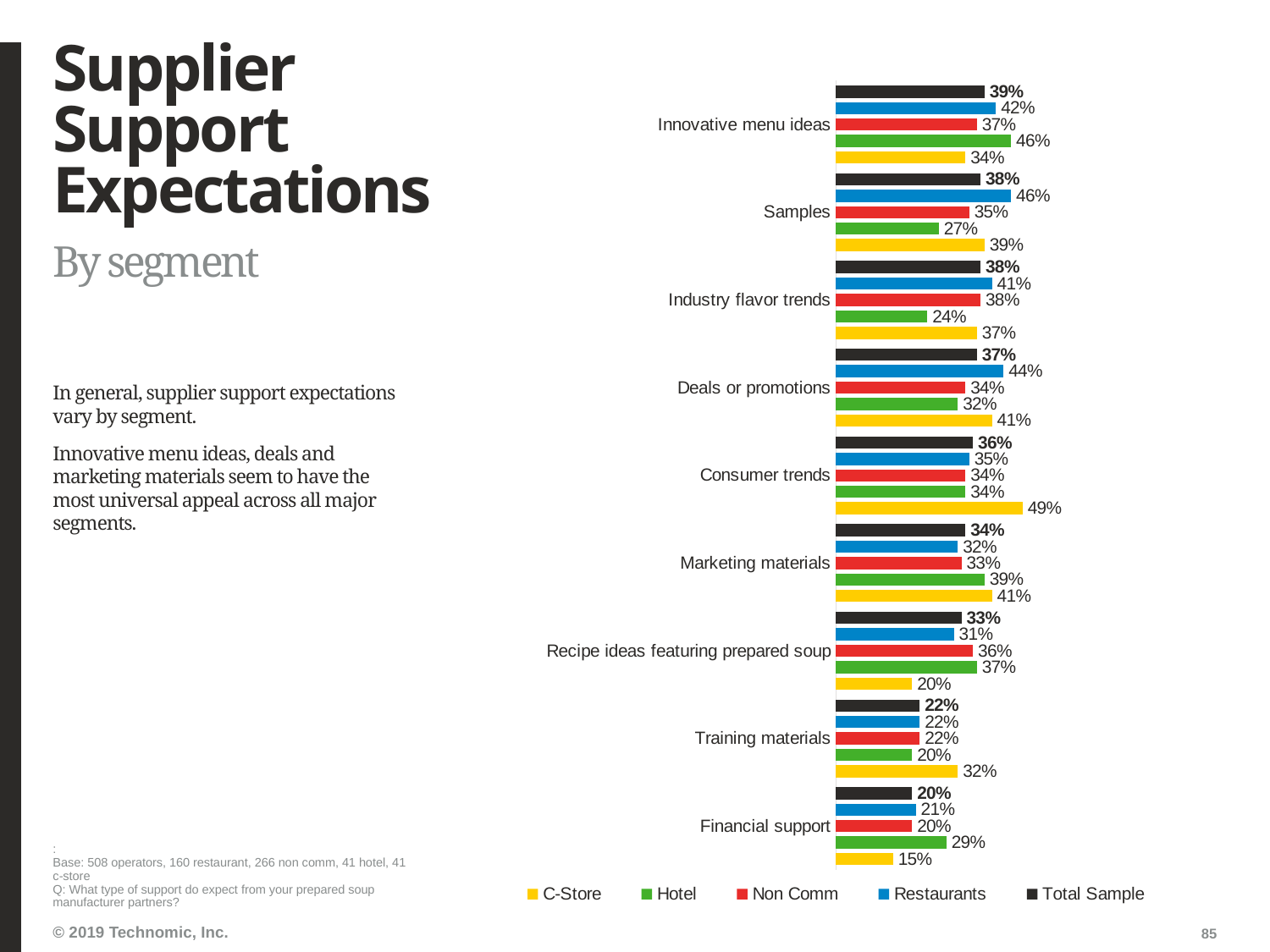
For Deals or promotions, which is larger: the Restaurants value or the Non Comm value? Restaurants What is the difference between the Hotel and C-Store values for Innovative menu ideas? 12% How many categories are shown on the chart? 9 Which category has the highest Total Sample value? Innovative menu ideas Which series is shown in yellow in the legend? C-Store What is the Total Sample value for Innovative menu ideas? 39% What is the Restaurants value for Samples? 46% What kind of chart is shown on the slide? Bar chart What is the Hotel value for Industry flavor trends? 24% Which category has the lowest C-Store value? Financial support What is the C-Store value for Consumer trends? 49% How many series does the legend list? 5